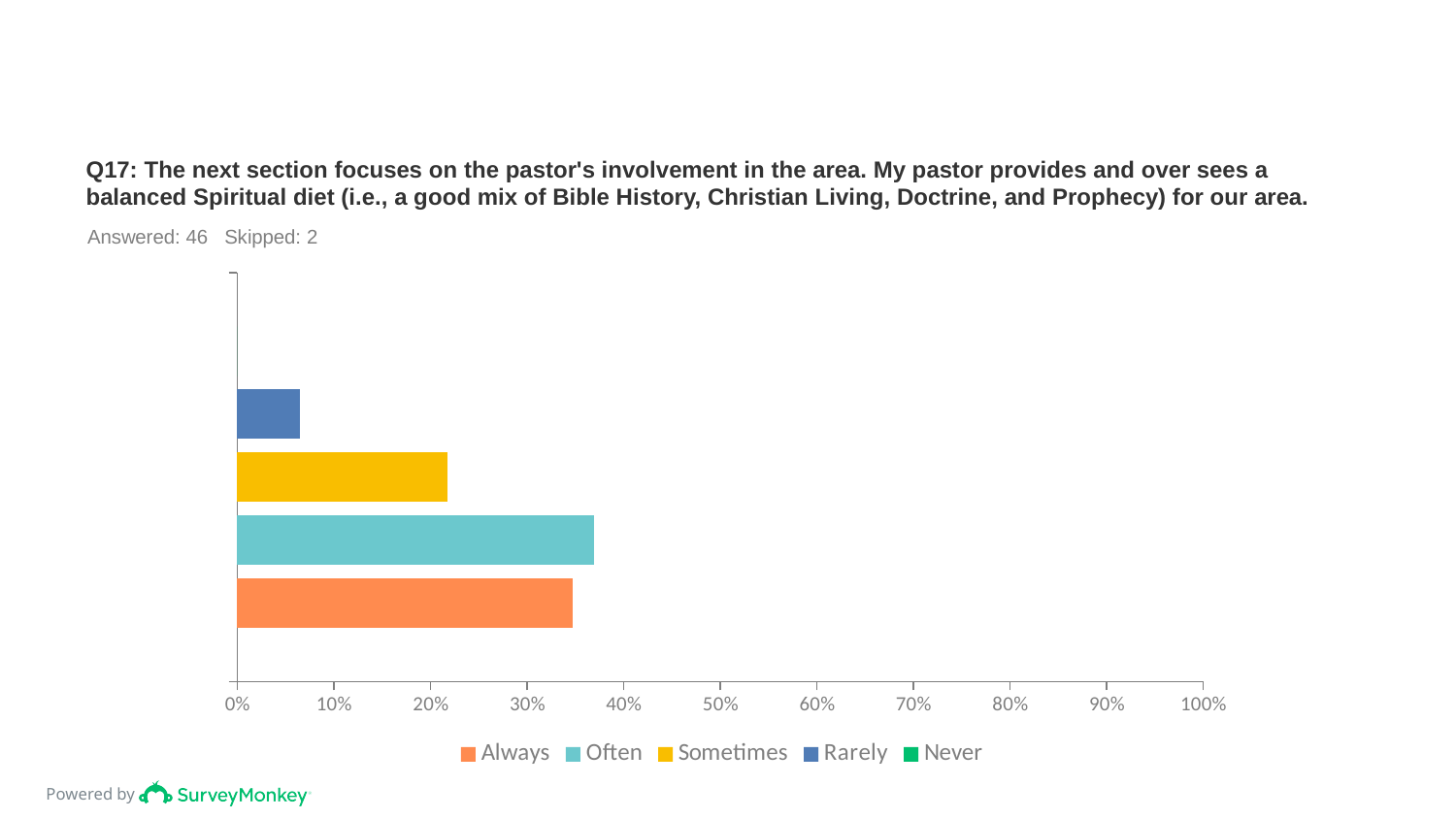
Is the value for Often greater or less than 30%? greater Is the value for Rarely greater or less than 10%? less Is the value for Sometimes greater or less than 30%? less Which is larger, the value for Always or the value for Sometimes? Always How many respondents answered this question according to the slide? 46 Which response option has the lowest share? Never How many response options does the legend list? 5 Which is larger, the value for Sometimes or the value for Rarely? Sometimes What kind of chart is shown on the slide? bar chart